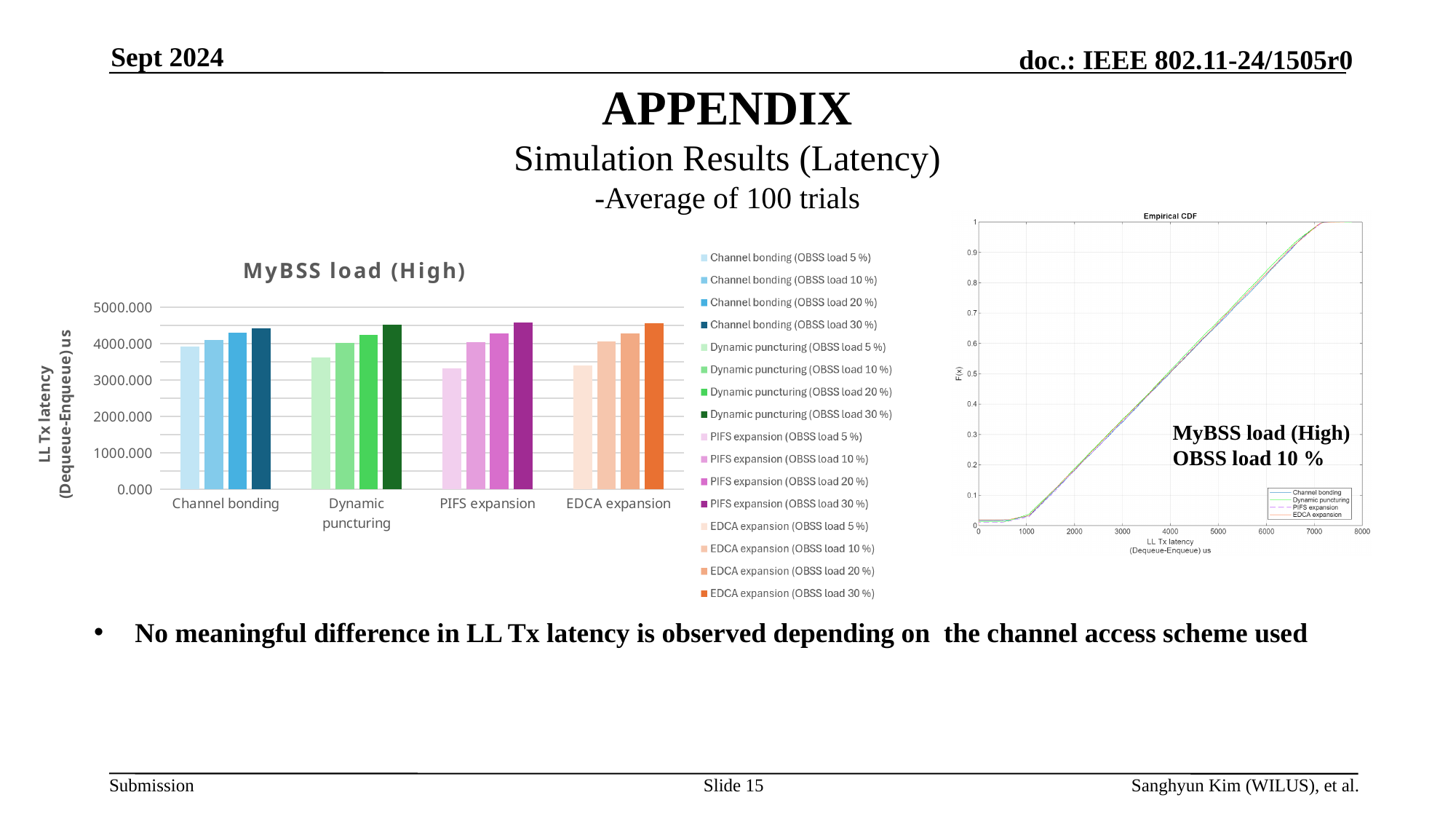
How many series does the legend of the 'Empirical CDF' chart list? 4 What is the x-axis label of the 'Empirical CDF' chart? LL Tx latency (Dequeue-Enqueue) us In the 'MyBSS load (High)' bar chart, is the value for Dynamic puncturing (OBSS load 5 %) greater or less than 4000.000? less What kind of chart is the 'Empirical CDF' chart on the right? line chart In the 'MyBSS load (High)' bar chart, do the bars within each category rise or fall as the OBSS load increases from 5 % to 30 %? rise How many channel access scheme categories are shown on the x axis of the 'MyBSS load (High)' bar chart? 4 How many series does the legend of the 'MyBSS load (High)' bar chart list? 16 What kind of chart is the 'MyBSS load (High)' chart on the left? bar chart In the 'MyBSS load (High)' bar chart, is the value for EDCA expansion (OBSS load 5 %) greater or less than 3000.000? greater In the 'MyBSS load (High)' bar chart, which is larger: PIFS expansion (OBSS load 5 %) or PIFS expansion (OBSS load 30 %)? PIFS expansion (OBSS load 30 %) In the 'MyBSS load (High)' bar chart, which OBSS load series has the lowest value within the Channel bonding group? Channel bonding (OBSS load 5 %) In the 'MyBSS load (High)' bar chart, is the value for PIFS expansion (OBSS load 30 %) greater or less than 4000.000? greater